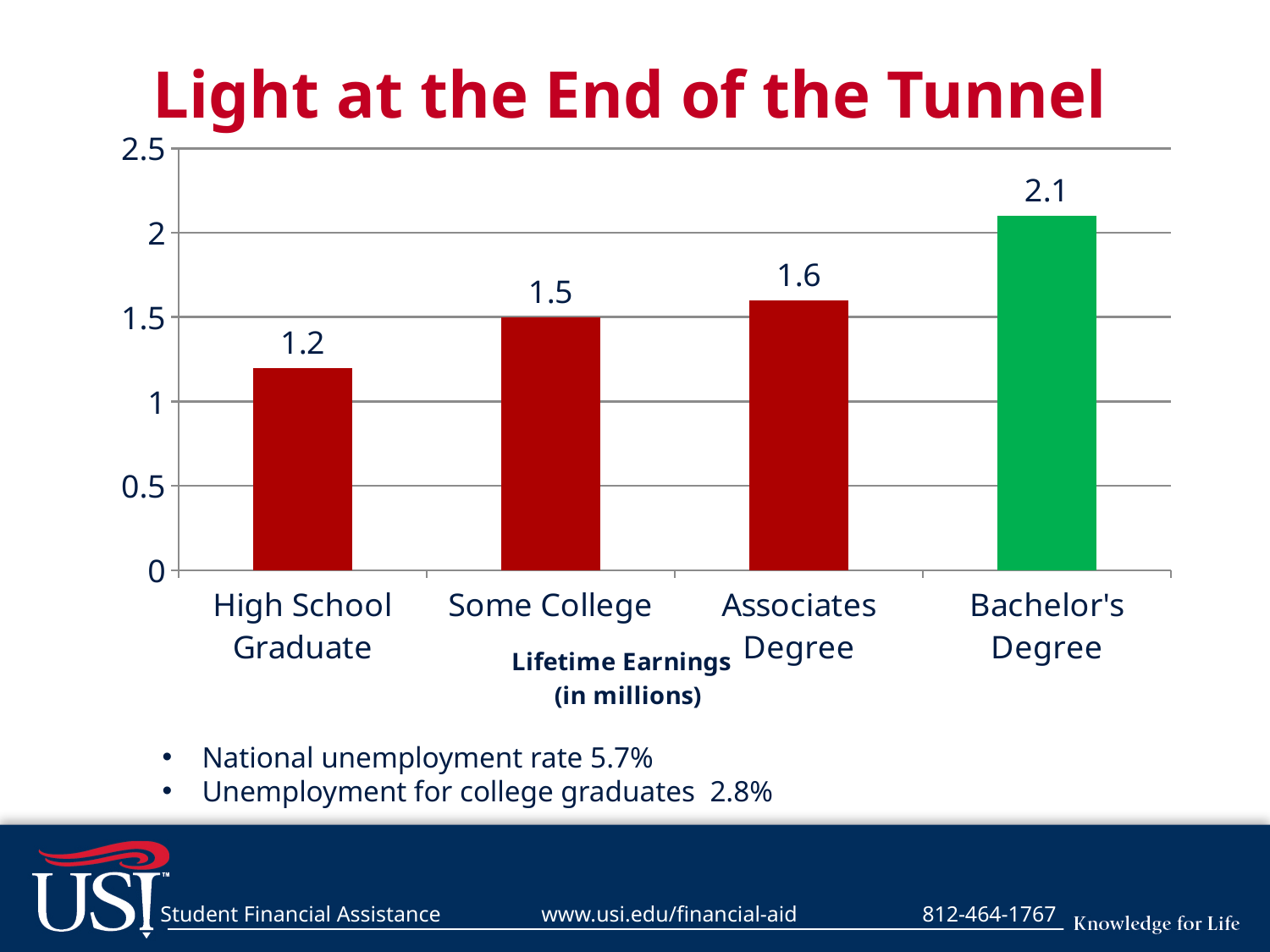
What kind of chart is shown on the slide? Bar chart What is the lifetime earnings value for High School Graduate? 1.2 What is the difference in lifetime earnings between Bachelor's Degree and High School Graduate? 0.9 What is the lifetime earnings value for Some College? 1.5 How many categories are shown in the chart? 4 Which category has the highest lifetime earnings? Bachelor's Degree Do the values rise or fall from left to right along the x axis? Rise Which has higher lifetime earnings, Some College or Associates Degree? Associates Degree Which category has the lowest lifetime earnings? High School Graduate What is the lifetime earnings value for Associates Degree? 1.6 Is the value for Bachelor's Degree greater or less than 2? greater What is the lifetime earnings value for Bachelor's Degree? 2.1